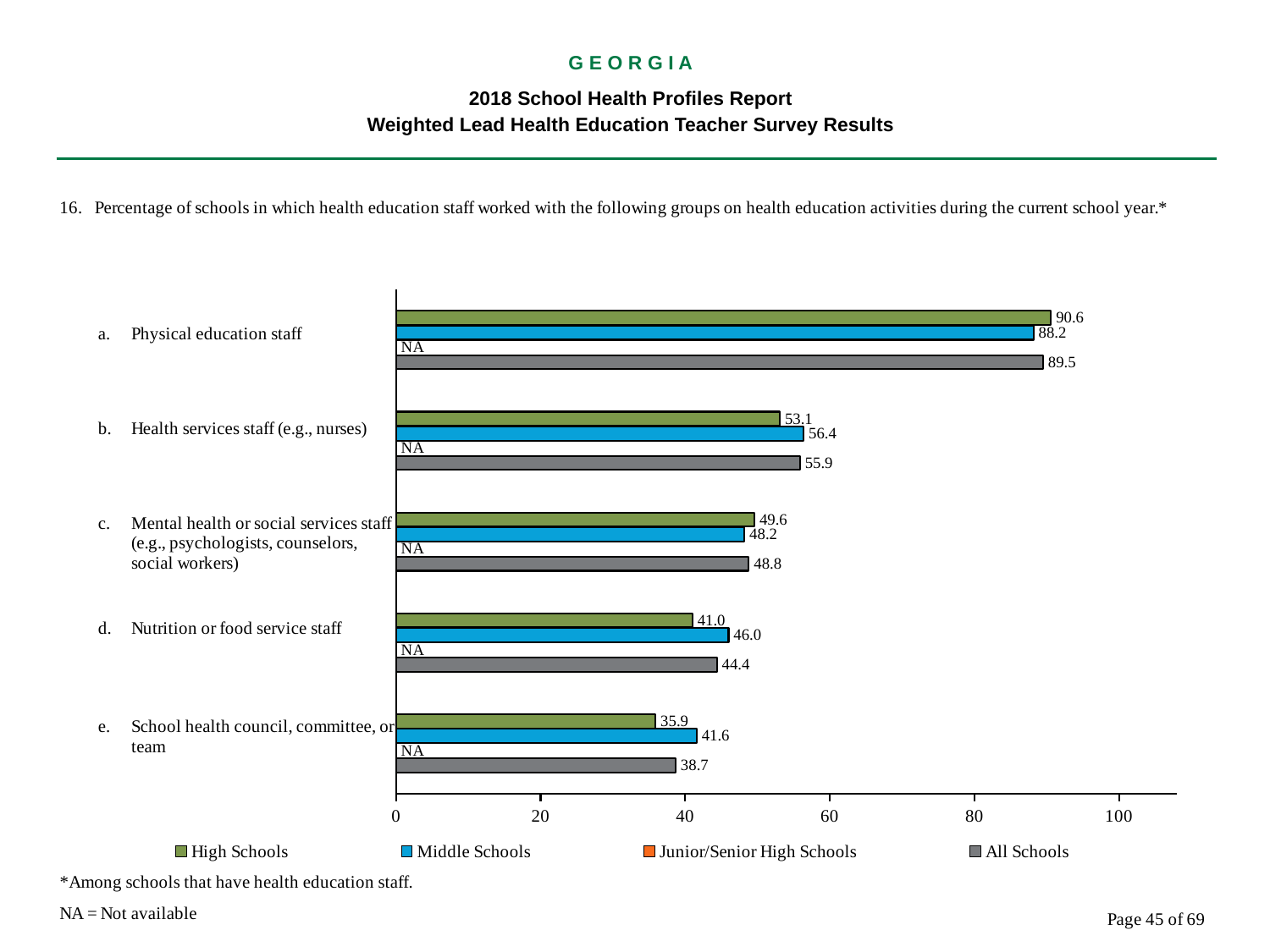
Which category has the lowest High Schools value? School health council, committee, or team How many series does the legend list? 4 Is the All Schools value for Health services staff (e.g., nurses) greater or less than 60? less What value is shown for Junior/Senior High Schools in each category? NA What is the Middle Schools value for Health services staff (e.g., nurses)? 56.4 How many categories are shown on the chart? 5 What is the All Schools value for Nutrition or food service staff? 44.4 Which category has the highest All Schools value? Physical education staff What is the difference between the Middle Schools and High Schools values for Nutrition or food service staff? 5.0 What is the High Schools value for Physical education staff? 90.6 What is the Middle Schools value for School health council, committee, or team? 41.6 Which is larger for Mental health or social services staff: the High Schools value or the Middle Schools value? High Schools